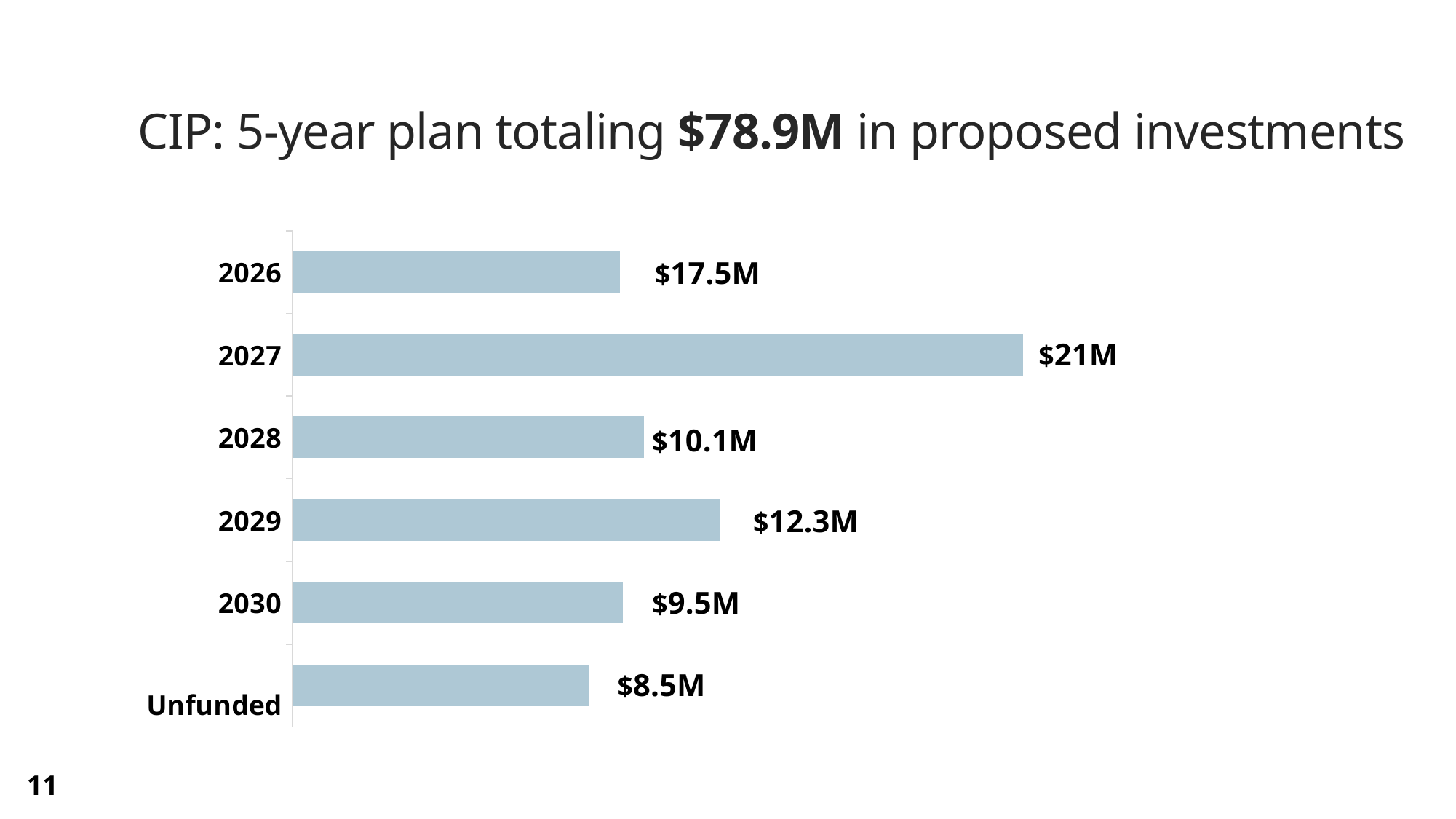
What kind of chart is shown on the slide? Bar chart What is the value for 2030? $9.5M What is the value for 2029? $12.3M What is the value for 2027? $21M What is the value for Unfunded? $8.5M What is the difference between the values for 2027 and 2026? $3.5M Which category has the lowest value? Unfunded How many categories are shown in the chart? 6 Which is larger, the value for 2028 or the value for 2030? 2028 What is the difference between the values for 2029 and 2028? $2.2M What total amount of proposed investments does the slide title state? $78.9M Which category has the highest value? 2027